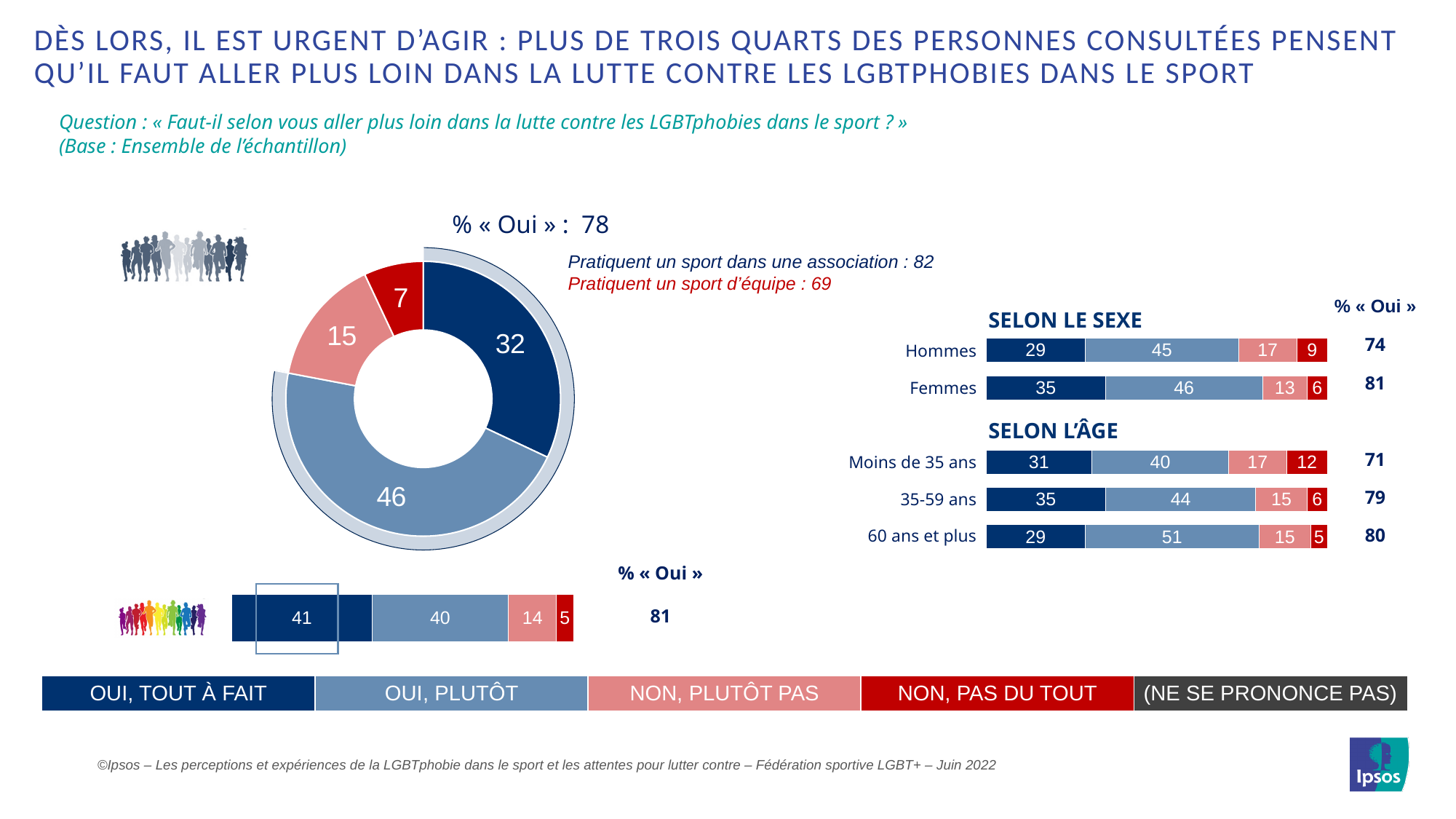
In the « Selon l'âge » bar chart, what is the difference between the « Non, pas du tout » values for Moins de 35 ans and 60 ans et plus? 7 In the « Selon le sexe » bar chart, what is the « Oui, plutôt » value for Femmes? 46 What kind of chart is the large chart on the left of the slide? Donut chart In the « Selon le sexe » bar chart, what is the « Non, pas du tout » value for Hommes? 9 In the bottom stacked bar chart (LGBT+ sample), what is the « Oui, tout à fait » value? 41 In the « Selon le sexe » bar chart, which group has the higher « Oui, tout à fait » value, Hommes or Femmes? Femmes In the donut chart, what is the value for « Oui, tout à fait »? 32 In the donut chart, which response category has the largest share? Oui, plutôt In the « Selon l'âge » bar chart, how many age groups are shown? 3 In the « Selon l'âge » bar chart, which age group has the highest « Oui, plutôt » value? 60 ans et plus How many response categories does the legend at the bottom of the slide list? 5 In the donut chart, which response category has the smallest share? Non, pas du tout